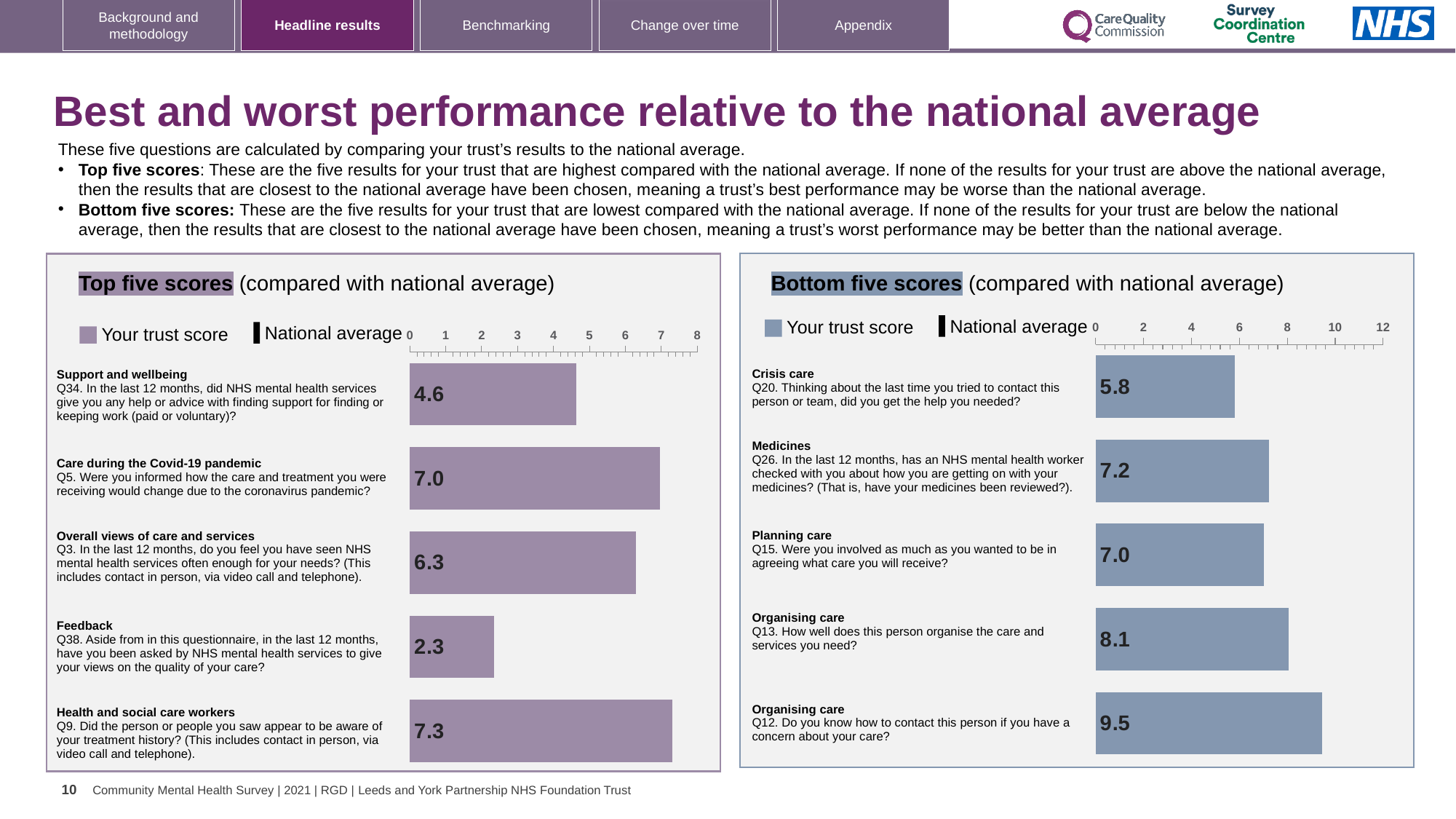
In the 'Top five scores' chart, which category has the lowest trust score? Feedback What type of chart is the 'Bottom five scores' chart? Bar chart In the 'Bottom five scores' chart, what is the difference between the trust scores for Organising care (Q12) and Organising care (Q13)? 1.4 In the 'Bottom five scores' chart, which category has the lowest trust score? Crisis care In the 'Top five scores' chart, what is the difference between the trust scores for Care during the Covid-19 pandemic and Overall views of care and services? 0.7 In the 'Bottom five scores' chart, what is the trust score for Organising care (Q12)? 9.5 In the 'Top five scores' chart, which category has the highest trust score? Health and social care workers In the 'Bottom five scores' chart, what is the trust score for Crisis care (Q20)? 5.8 In the 'Top five scores' chart, what is the trust score for Feedback (Q38)? 2.3 How many categories are plotted in the 'Top five scores' chart? 5 In the 'Top five scores' chart, what is the trust score for Support and wellbeing (Q34)? 4.6 In the 'Bottom five scores' chart, which is larger: the trust score for Medicines or for Planning care? Medicines